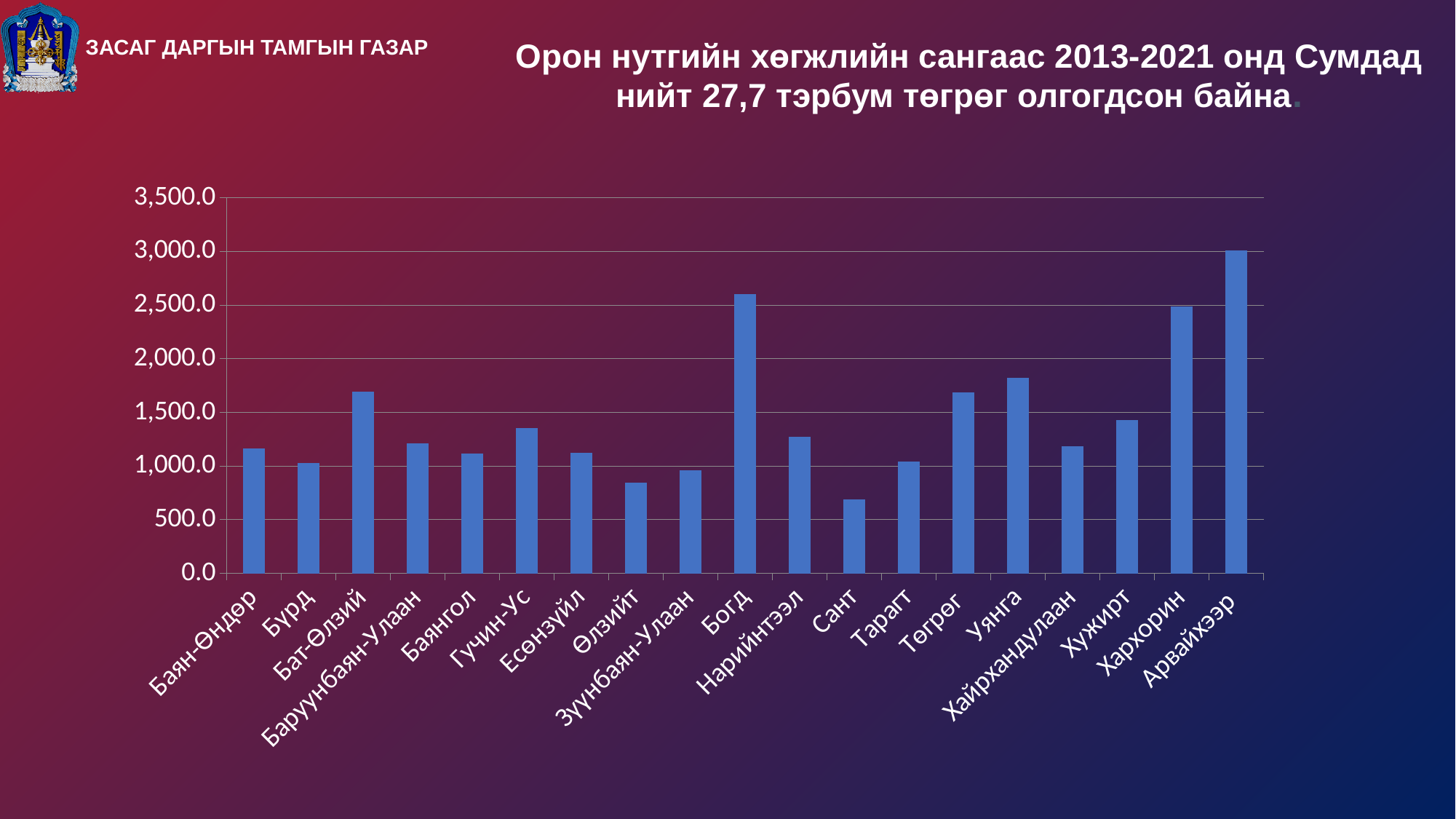
Is the value for Хархорин greater or less than 2,000.0? greater Which is larger, the value for Уянга or the value for Төгрөг? Уянга How many categories (sums) are shown on the x axis of the chart? 19 Is the value for Сант greater or less than 1,000.0? less What kind of chart is shown on the slide? bar chart Which category has the highest bar in the chart? Арвайхээр Is the value for Уянга greater or less than 1,500.0? greater Which is larger, the value for Арвайхээр or the value for Богд? Арвайхээр Which category has the lowest bar in the chart? Сант What is the highest tick value shown on the y axis of the chart? 3,500.0